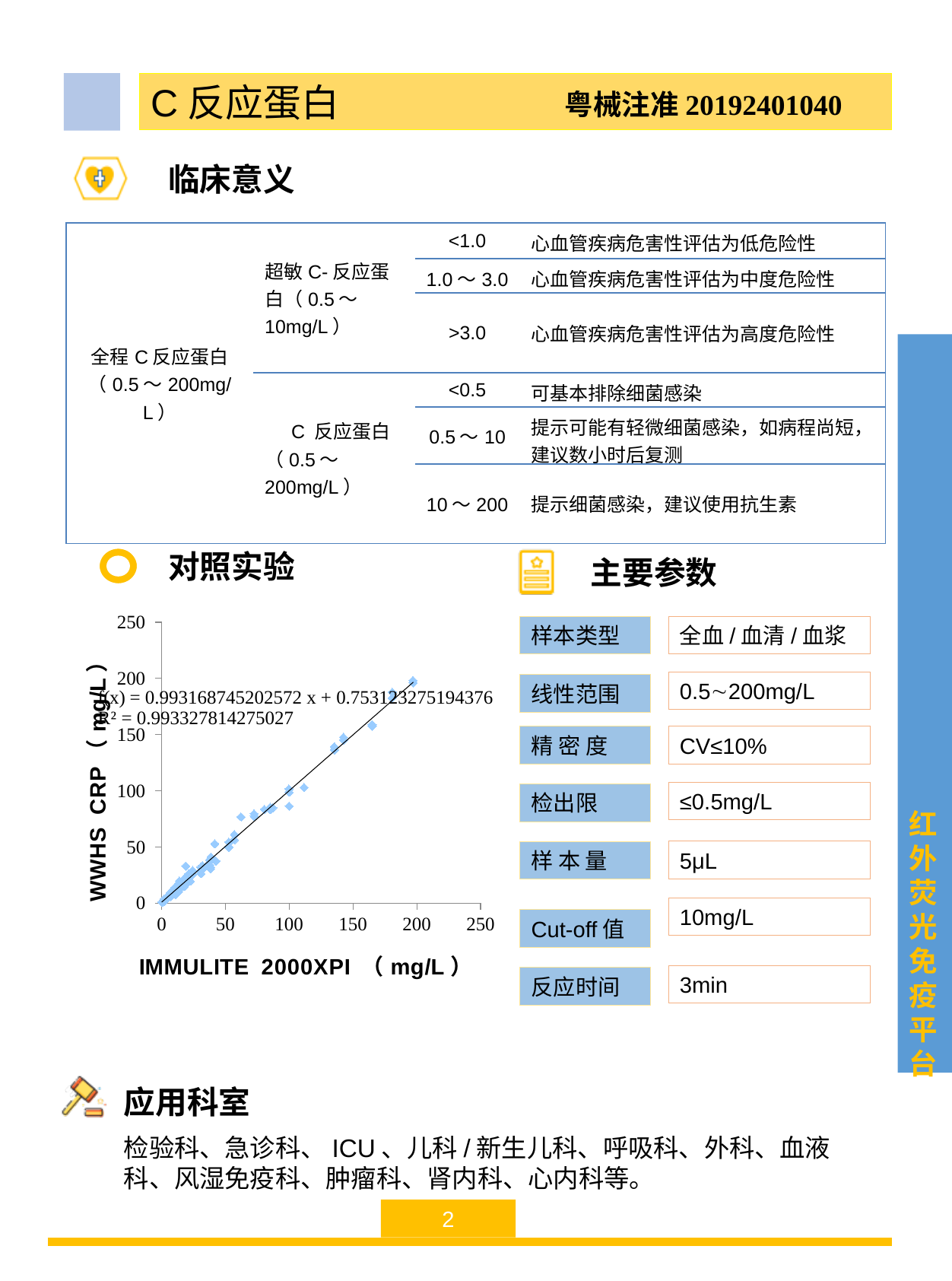
Do the WWHS CRP values rise or fall as the IMMULITE 2000XPI values increase along the x axis? rise What is the R² value printed on the scatter chart? 0.993327814275027 What is the intercept of the fitted line shown in the equation on the scatter chart? 0.753123275194376 What is the label of the y axis of the scatter chart? WWHS CRP (mg/L) What is the maximum value shown on the y axis of the scatter chart? 250 What is the label of the x axis of the scatter chart? IMMULITE 2000XPI (mg/L) What kind of chart is shown under the heading 对照实验? scatter chart Is the y value of the highest point on the scatter chart greater or less than 150? greater What is the interval between consecutive tick marks on the x axis of the scatter chart? 50 What is the maximum value shown on the x axis of the scatter chart? 250 What is the slope of the fitted line shown in the equation on the scatter chart? 0.993168745202572